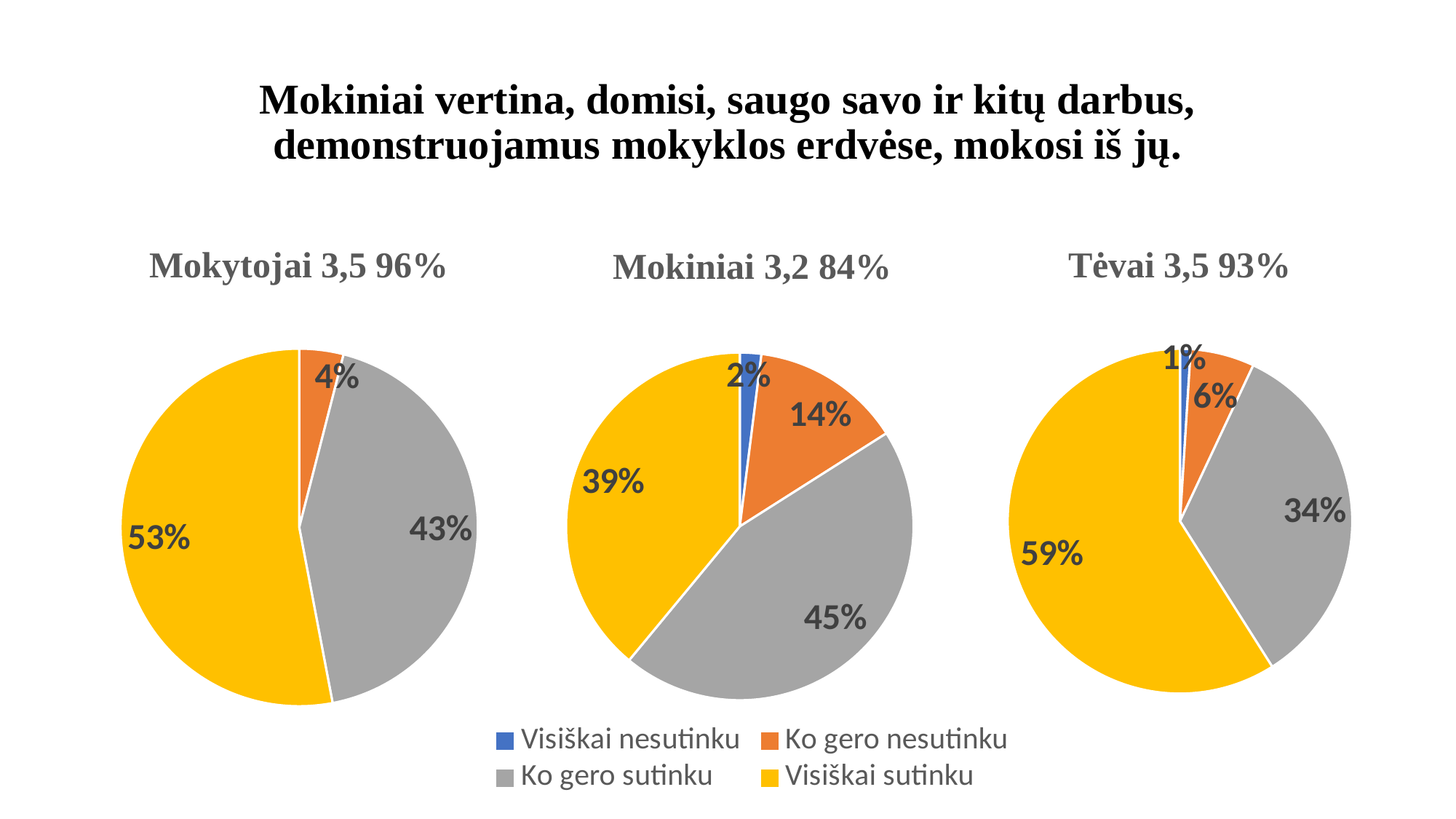
In the 'Tėvai 3,5 93%' chart, which category has the smallest slice? Visiškai nesutinku Which is larger: the 'Ko gero nesutinku' share in the 'Mokiniai 3,2 84%' chart or in the 'Tėvai 3,5 93%' chart? Mokiniai 3,2 84% In the 'Mokytojai 3,5 96%' chart, what share is 'Ko gero nesutinku'? 4% In the 'Mokytojai 3,5 96%' chart, what is the difference between the 'Visiškai sutinku' and 'Ko gero sutinku' shares? 10% What kind of charts are shown on the slide? Pie charts In the 'Mokytojai 3,5 96%' chart, what share is 'Visiškai sutinku'? 53% In the 'Mokiniai 3,2 84%' chart, what share is 'Visiškai nesutinku'? 2% In the 'Tėvai 3,5 93%' chart, what share is 'Ko gero nesutinku'? 6% How many entries does the legend list? 4 In the 'Mokiniai 3,2 84%' chart, what share is 'Ko gero sutinku'? 45% In the 'Mokiniai 3,2 84%' chart, which category has the largest slice? Ko gero sutinku In the 'Tėvai 3,5 93%' chart, what share is 'Visiškai sutinku'? 59%